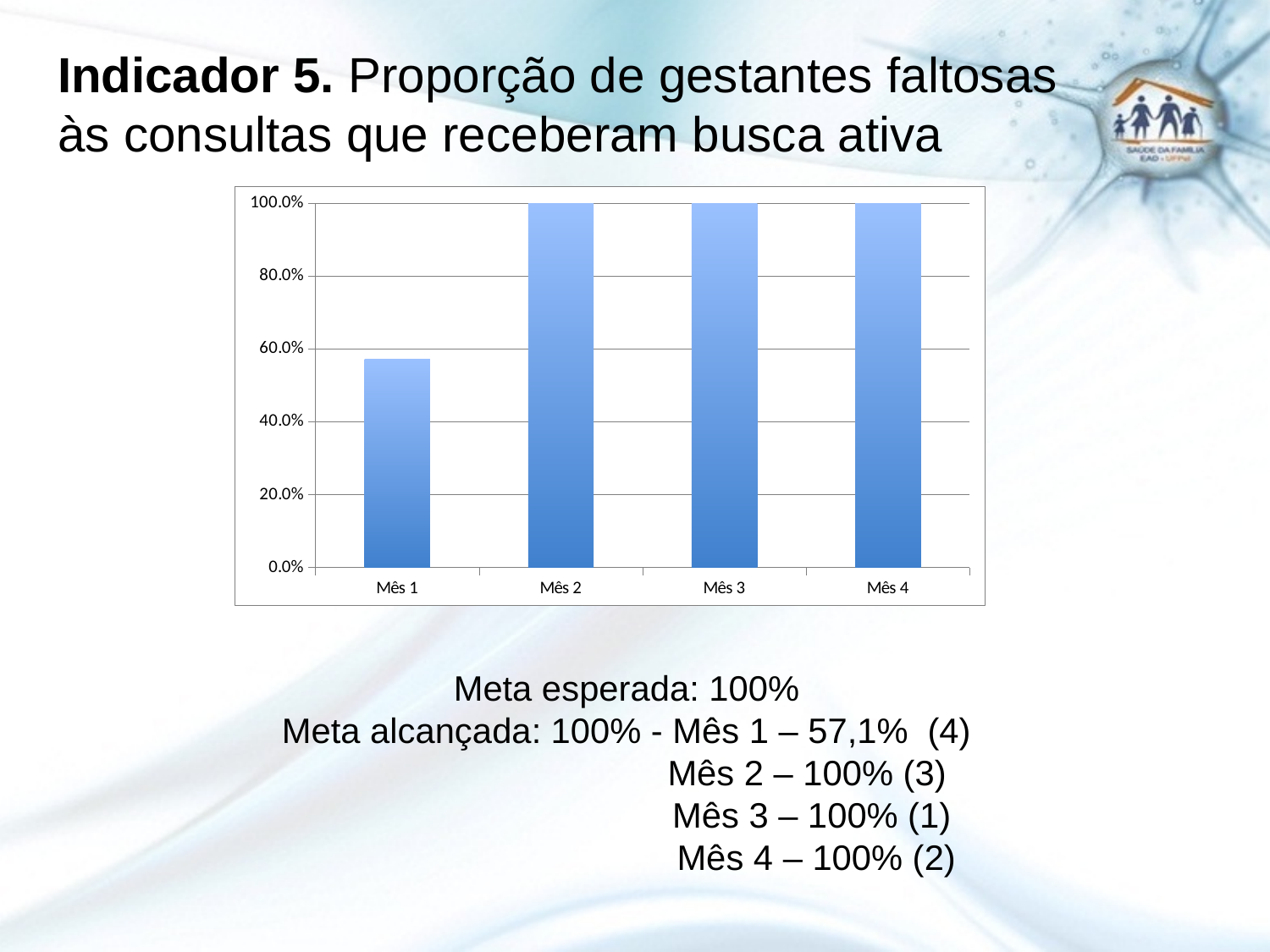
Do the values rise or fall from Mês 1 to Mês 2? rise Which month has the lowest value on the chart? Mês 1 Which is larger, the value for Mês 1 or the value for Mês 3? Mês 3 What is the expected target (meta esperada) stated on the slide? 100% Is the value for Mês 1 greater or less than 40.0%? greater What kind of chart is shown on the slide? bar chart What is the value for Mês 1 according to the slide? 57,1% What is the value for Mês 4 on the chart? 100% What is the highest value shown on the vertical axis of the chart? 100.0% How many categories (months) are plotted on the chart? 4 What is the value for Mês 2 on the chart? 100% Is the value for Mês 1 greater or less than 60.0%? less